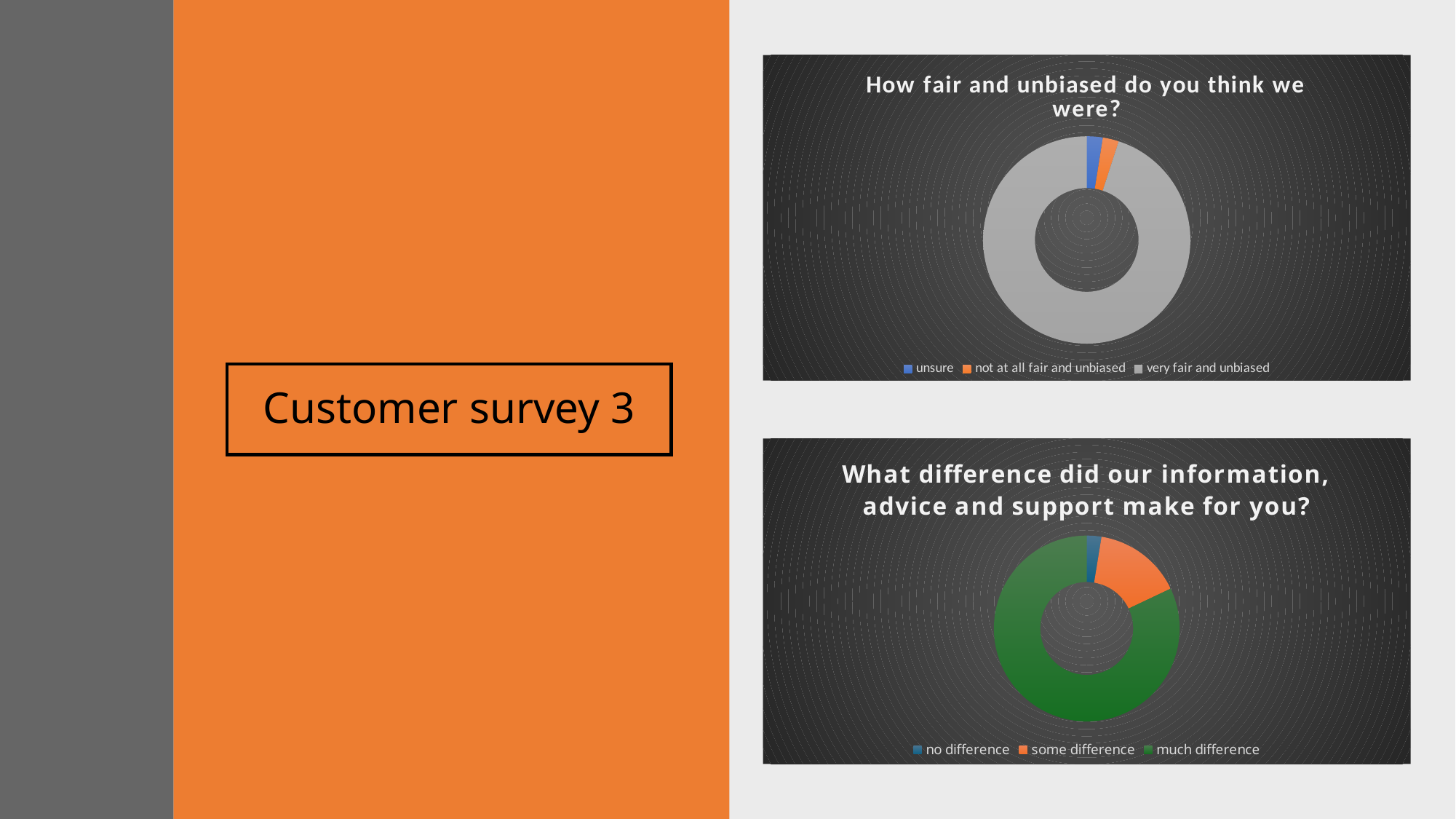
How many categories does the legend of the bottom chart, "What difference did our information, advice and support make for you?", list? 3 How many charts are shown on the slide? 2 In the top chart, "How fair and unbiased do you think we were?", which category has the largest share? very fair and unbiased In the bottom chart, "What difference did our information, advice and support make for you?", which category has the smallest share? no difference What kind of chart is the bottom chart, titled "What difference did our information, advice and support make for you?"? Doughnut chart In the bottom chart, what colour represents "much difference"? Green In the top chart, "How fair and unbiased do you think we were?", which is larger: "very fair and unbiased" or "not at all fair and unbiased"? very fair and unbiased In the bottom chart, "What difference did our information, advice and support make for you?", which is larger: "some difference" or "no difference"? some difference In the top chart, "How fair and unbiased do you think we were?", what colour represents "very fair and unbiased"? Grey What kind of chart is the top chart, titled "How fair and unbiased do you think we were?"? Doughnut chart How many categories does the legend of the top chart, "How fair and unbiased do you think we were?", list? 3 In the bottom chart, "What difference did our information, advice and support make for you?", which category has the largest share? much difference